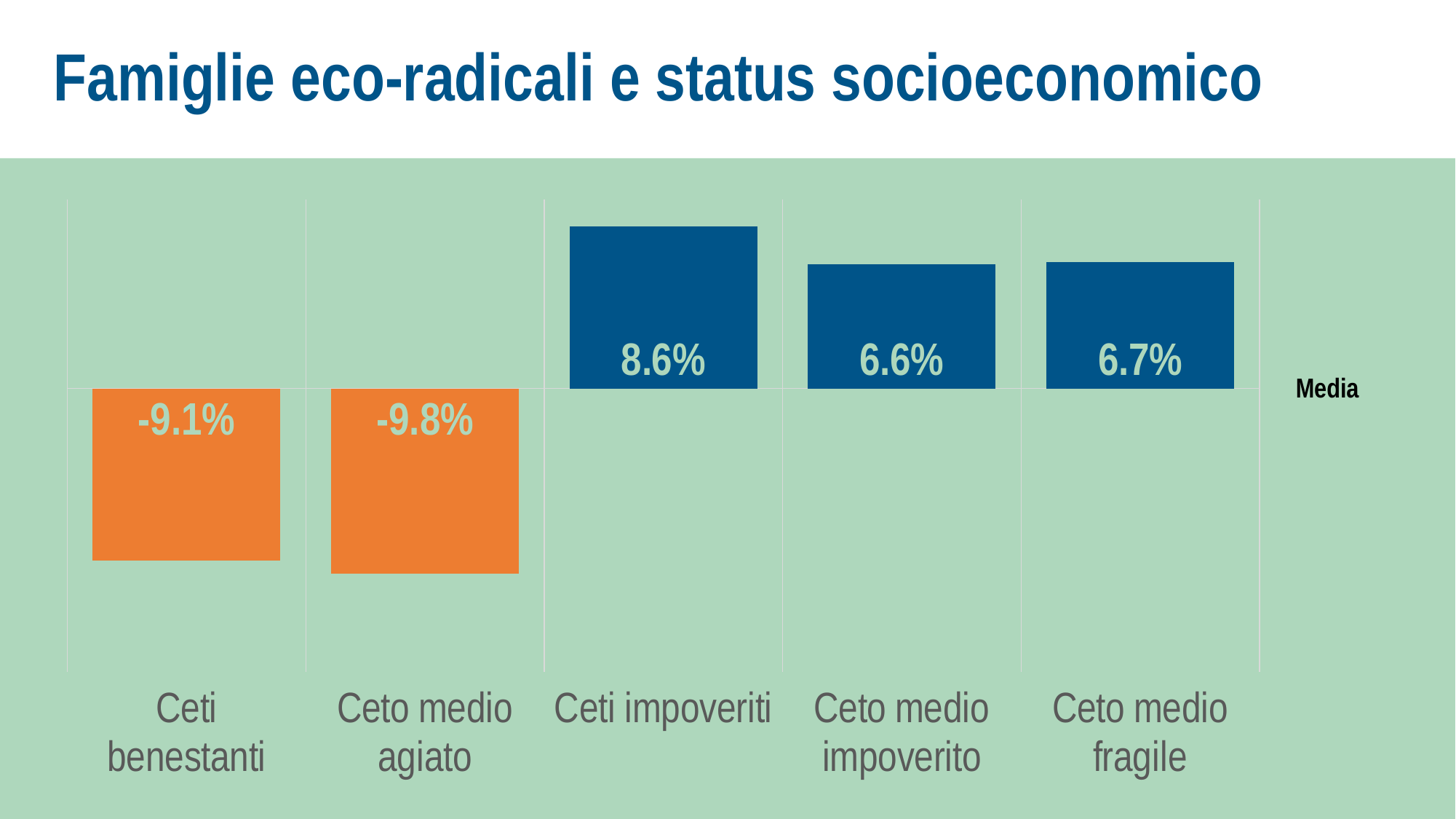
What is the title of the slide? Famiglie eco-radicali e status socioeconomico What is the value for Ceto medio agiato? -9.8% What is the value for Ceto medio fragile? 6.7% What is the value for Ceti benestanti? -9.1% What is the value for Ceto medio impoverito? 6.6% Which category has the lowest value? Ceto medio agiato What kind of chart is shown on the slide? Bar chart What is the value for Ceti impoveriti? 8.6% Which category has the highest value? Ceti impoveriti How many categories are shown in the chart? 5 What is the difference between the values for Ceti impoveriti and Ceto medio impoverito? 2.0% Which is larger, the value for Ceti impoveriti or the value for Ceto medio fragile? Ceti impoveriti